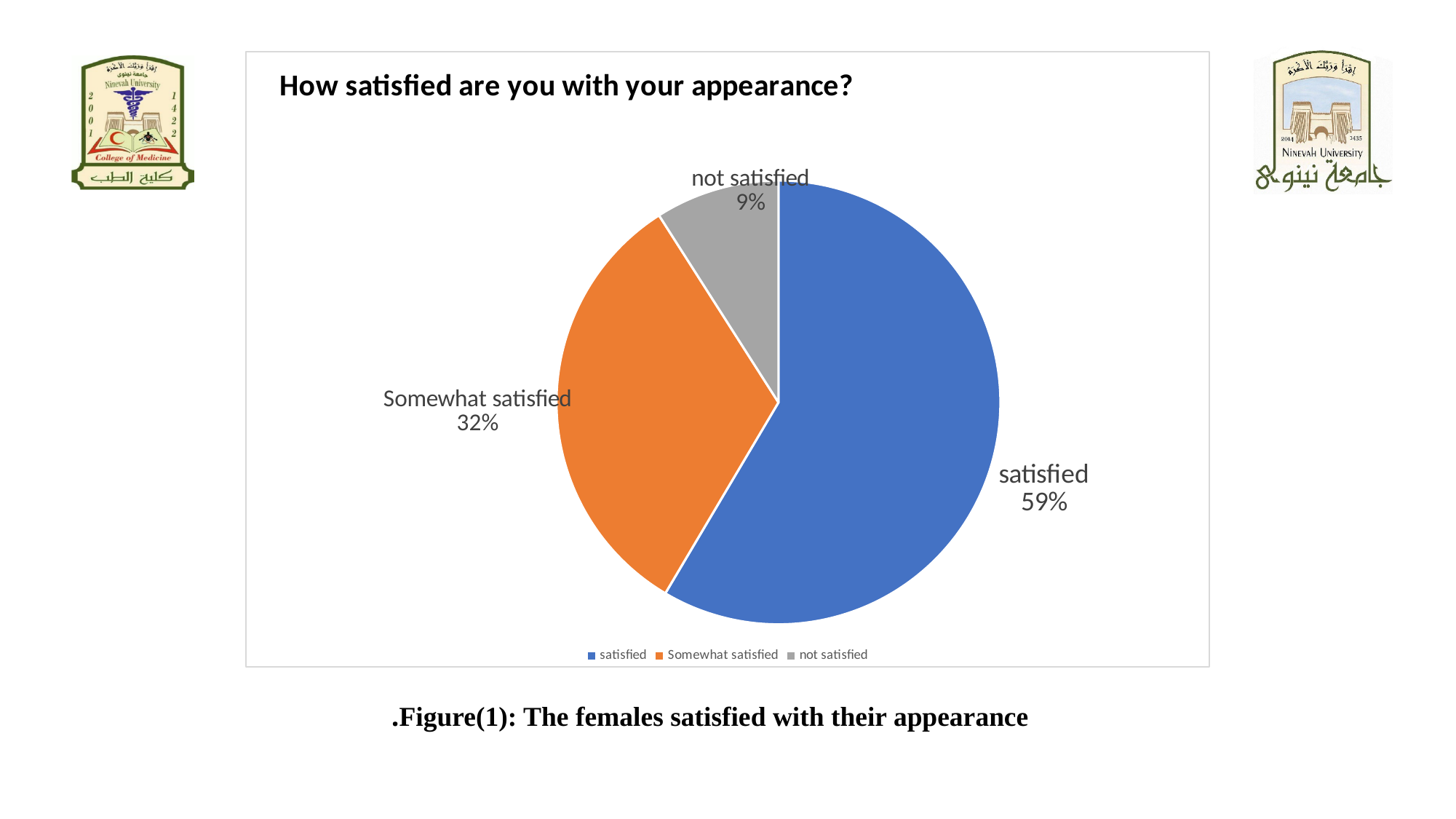
Which category has the smallest slice of the pie? not satisfied What is the difference in percentage points between the "satisfied" and "Somewhat satisfied" slices? 27 What colour is the "Somewhat satisfied" slice? orange What is the difference in percentage points between the "Somewhat satisfied" and "not satisfied" slices? 23 What share of the pie is labelled "not satisfied"? 9% Which slice is larger, "Somewhat satisfied" or "not satisfied"? Somewhat satisfied What kind of chart is shown on the slide? pie chart What is the title of the chart? How satisfied are you with your appearance? What share of the pie is labelled "satisfied"? 59% How many categories does the pie chart show? 3 Which category has the largest slice of the pie? satisfied What share of the pie is labelled "Somewhat satisfied"? 32%